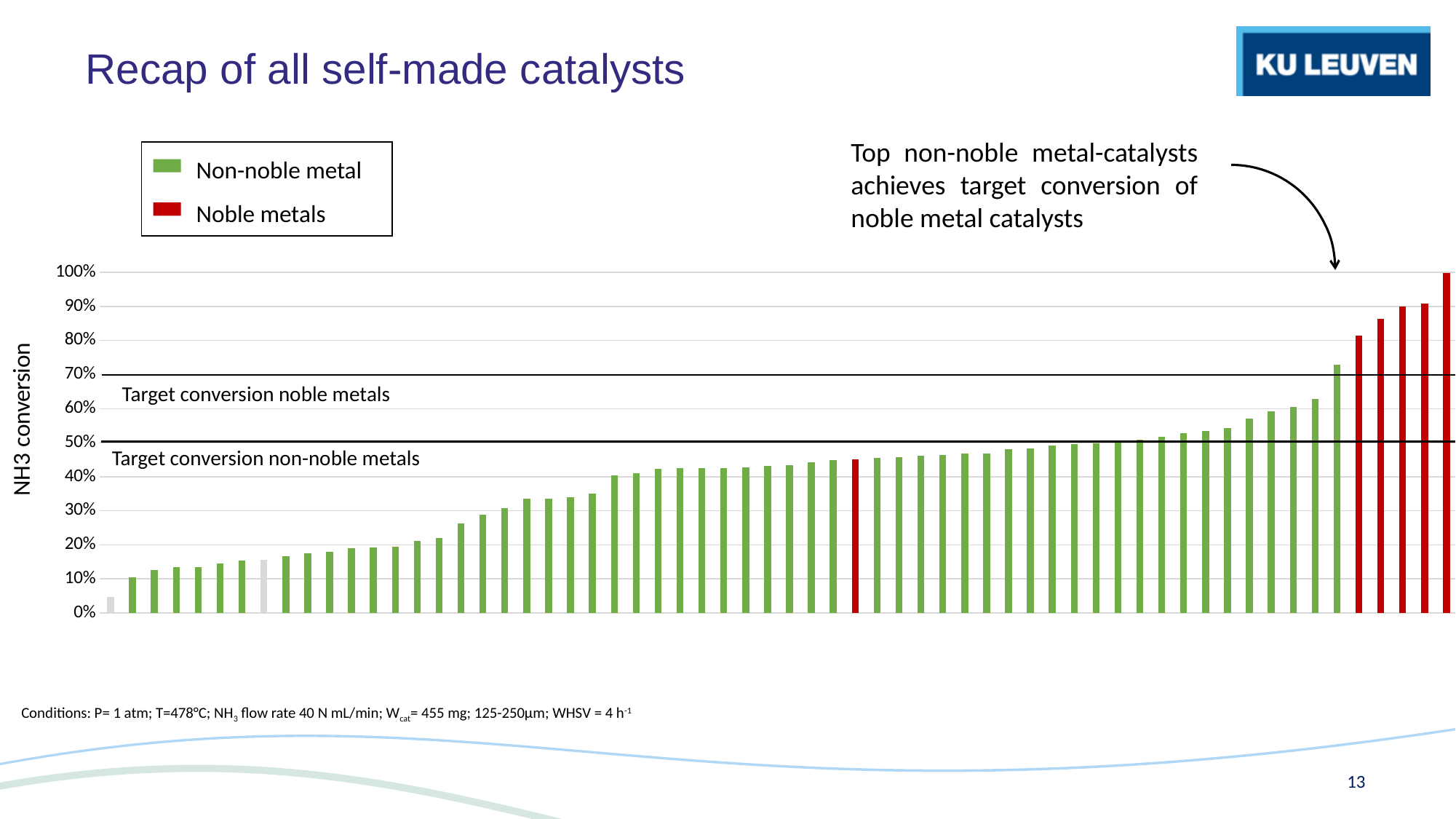
Is the value of the tallest green bar greater or less than 60%? greater How many red (noble metal) bars are in the chart? 6 Is the value of the rightmost bar greater or less than 90%? greater Do the bar values rise or fall from left to right along the x axis? rise Which is larger, the rightmost red bar or the tallest green bar? the rightmost red bar At what conversion level is the 'Target conversion non-noble metals' line drawn? 50% Which two entries appear in the legend? Non-noble metal and Noble metals Is the value of the leftmost bar greater or less than 10%? less At what conversion level is the 'Target conversion noble metals' line drawn? 70% How many series does the legend list? 2 What kind of chart is shown on the slide? bar chart What is the label of the vertical axis? NH3 conversion